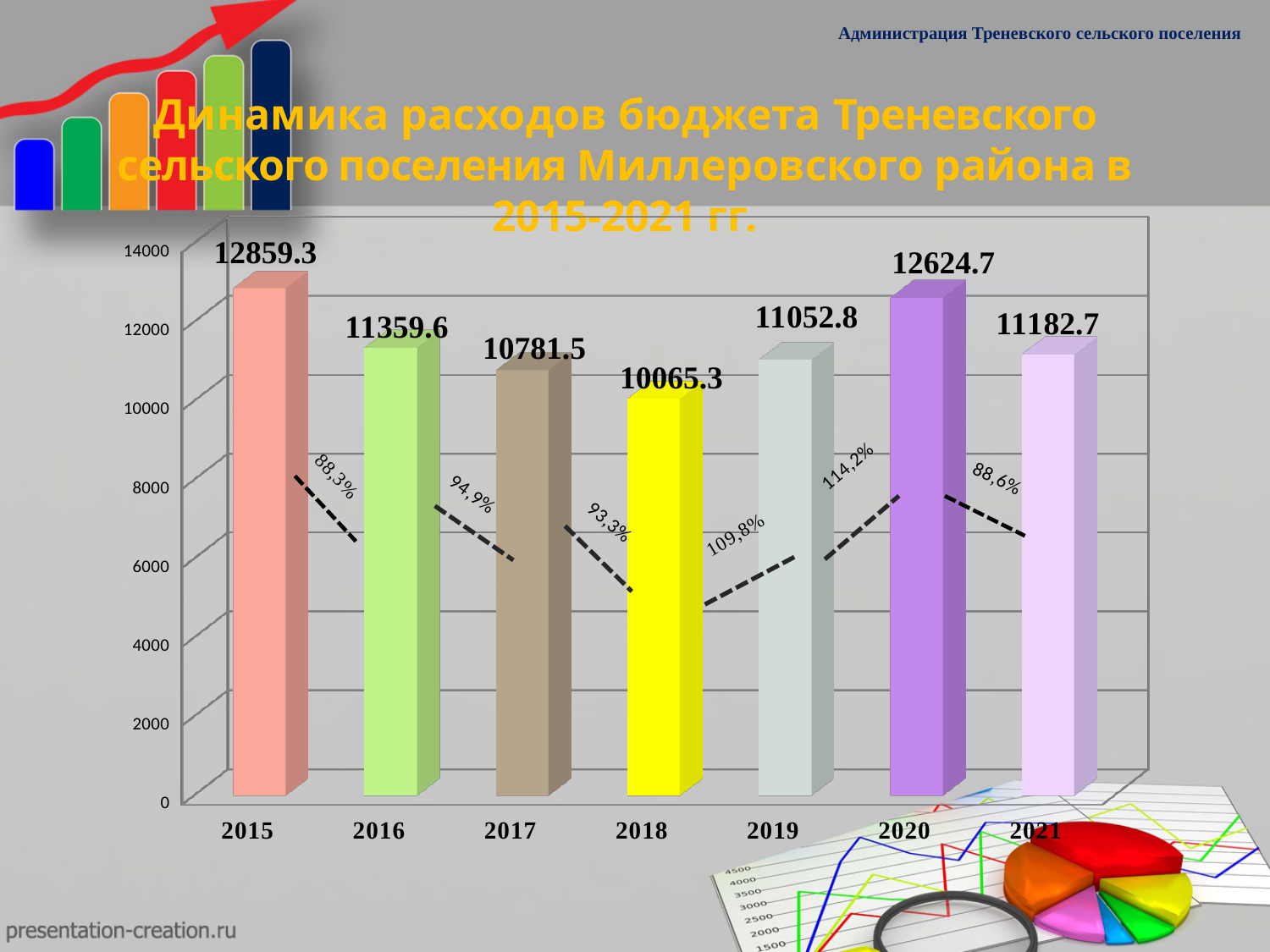
What is the value for 2018? 10065.3 Which year has the highest value? 2015 What is the value for 2020? 12624.7 What is the value for 2015? 12859.3 What is the value for 2021? 11182.7 What is the difference between the values for 2020 and 2019? 1571.9 How many years are shown on the x axis? 7 From 2015 to 2018, do the values rise or fall? fall What kind of chart is this? bar chart Which year has the lowest value? 2018 What is the difference between the values for 2015 and 2018? 2794 Which is larger, the value for 2016 or the value for 2021? 2016